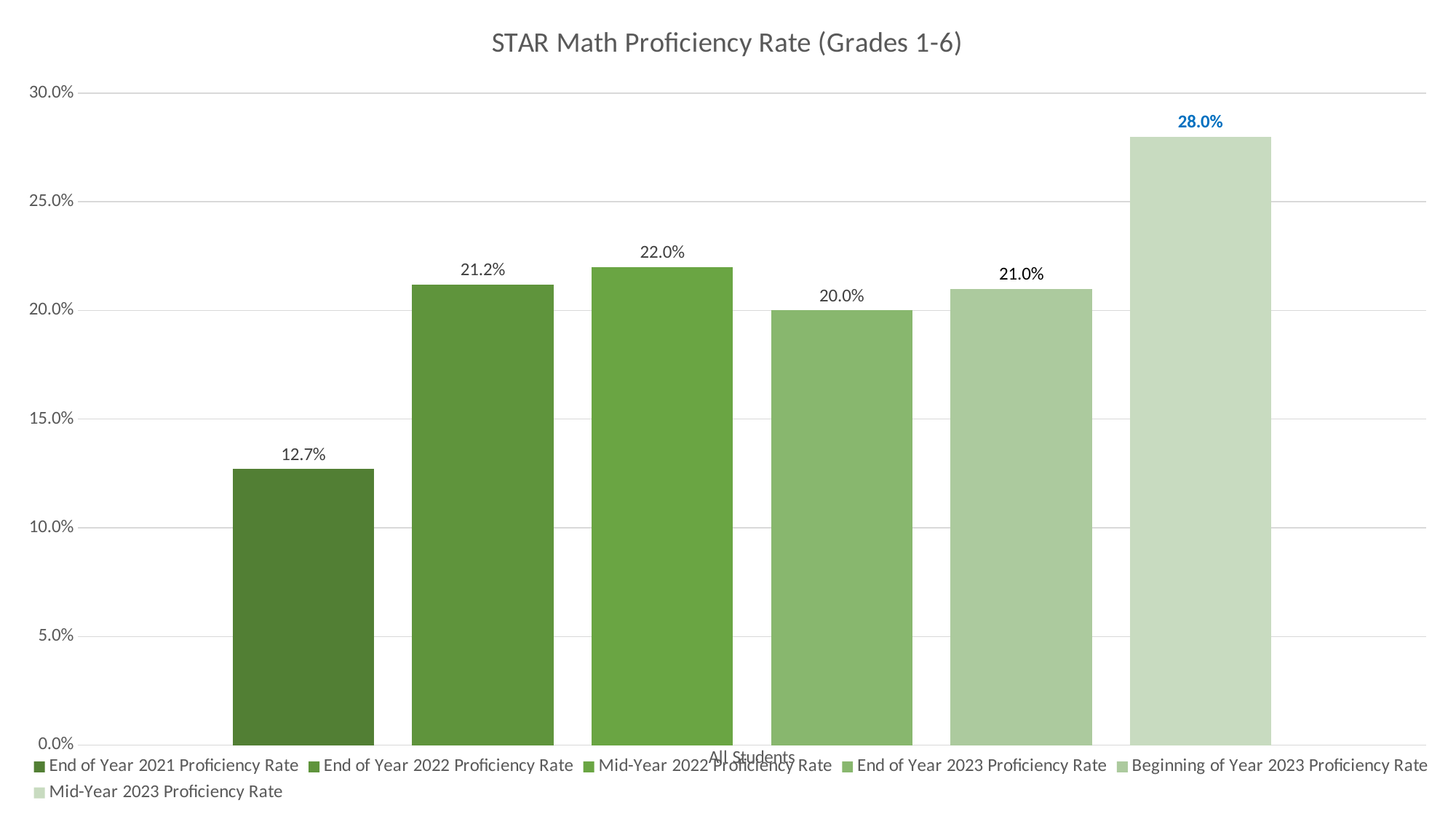
What is the End of Year 2023 Proficiency Rate? 20.0% How many series does the legend list? 6 Which series has the highest proficiency rate? Mid-Year 2023 Proficiency Rate What is the End of Year 2021 Proficiency Rate? 12.7% Which series has the lowest proficiency rate? End of Year 2021 Proficiency Rate What is the difference between the Mid-Year 2023 Proficiency Rate and the End of Year 2021 Proficiency Rate? 15.3% What kind of chart is shown on the slide? Bar chart What is the difference between the Mid-Year 2022 Proficiency Rate and the End of Year 2022 Proficiency Rate? 0.8% Is the Beginning of Year 2023 Proficiency Rate greater or less than 20.0%? greater What is the title of the chart? STAR Math Proficiency Rate (Grades 1-6) Which is larger, the End of Year 2022 Proficiency Rate or the End of Year 2023 Proficiency Rate? End of Year 2022 Proficiency Rate What is the Mid-Year 2023 Proficiency Rate? 28.0%